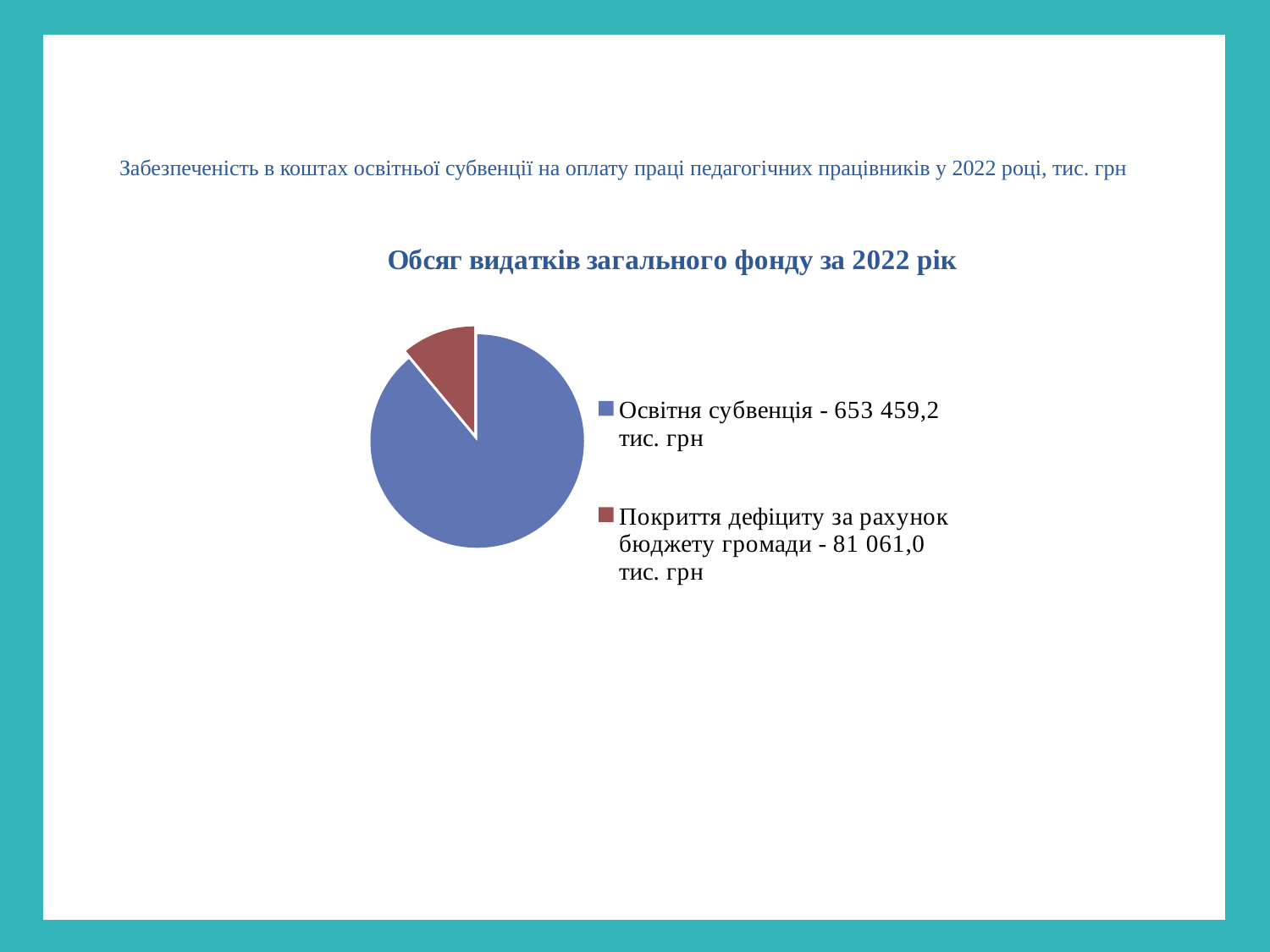
How many slices does the pie chart have? 2 Which category has the largest slice of the pie? Освітня субвенція What is the total of the two categories in the pie chart? 734 520,2 тис. грн What is the value for Покриття дефіциту за рахунок бюджету громади? 81 061,0 тис. грн How many entries does the legend list? 2 What is the title of the chart? Обсяг видатків загального фонду за 2022 рік What is the value for Освітня субвенція? 653 459,2 тис. грн Which category has the smallest slice of the pie? Покриття дефіциту за рахунок бюджету громади What is the difference between Освітня субвенція and Покриття дефіциту за рахунок бюджету громади? 572 398,2 тис. грн What type of chart is shown on the slide? Pie chart Which is larger: Освітня субвенція or Покриття дефіциту за рахунок бюджету громади? Освітня субвенція What colour is the slice for Освітня субвенція? Blue